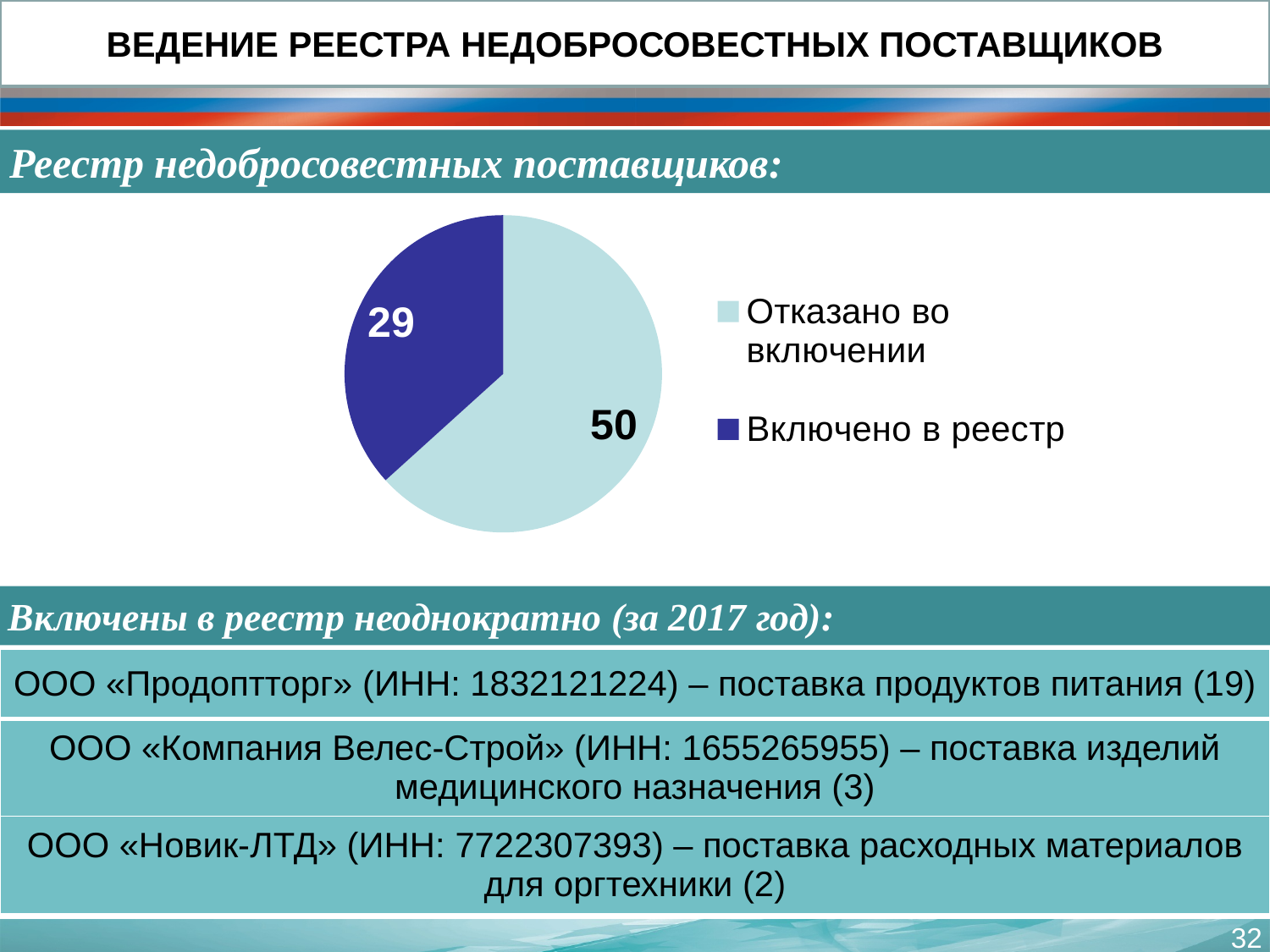
What is the difference between the values for "Отказано во включении" and "Включено в реестр"? 21 Which category has the largest slice in the pie chart? Отказано во включении Which is larger: the value for "Отказано во включении" or for "Включено в реестр"? Отказано во включении What type of chart is shown on the slide? pie chart What is the value for "Включено в реестр" in the pie chart? 29 How many slices does the pie chart have? 2 What colour is the slice for "Включено в реестр" in the pie chart? dark blue Which category has the smallest slice in the pie chart? Включено в реестр What is the value for "Отказано во включении" in the pie chart? 50 What is the total of the two values shown in the pie chart? 79 How many entries does the legend of the pie chart list? 2 What is the heading above the pie chart? Реестр недобросовестных поставщиков: